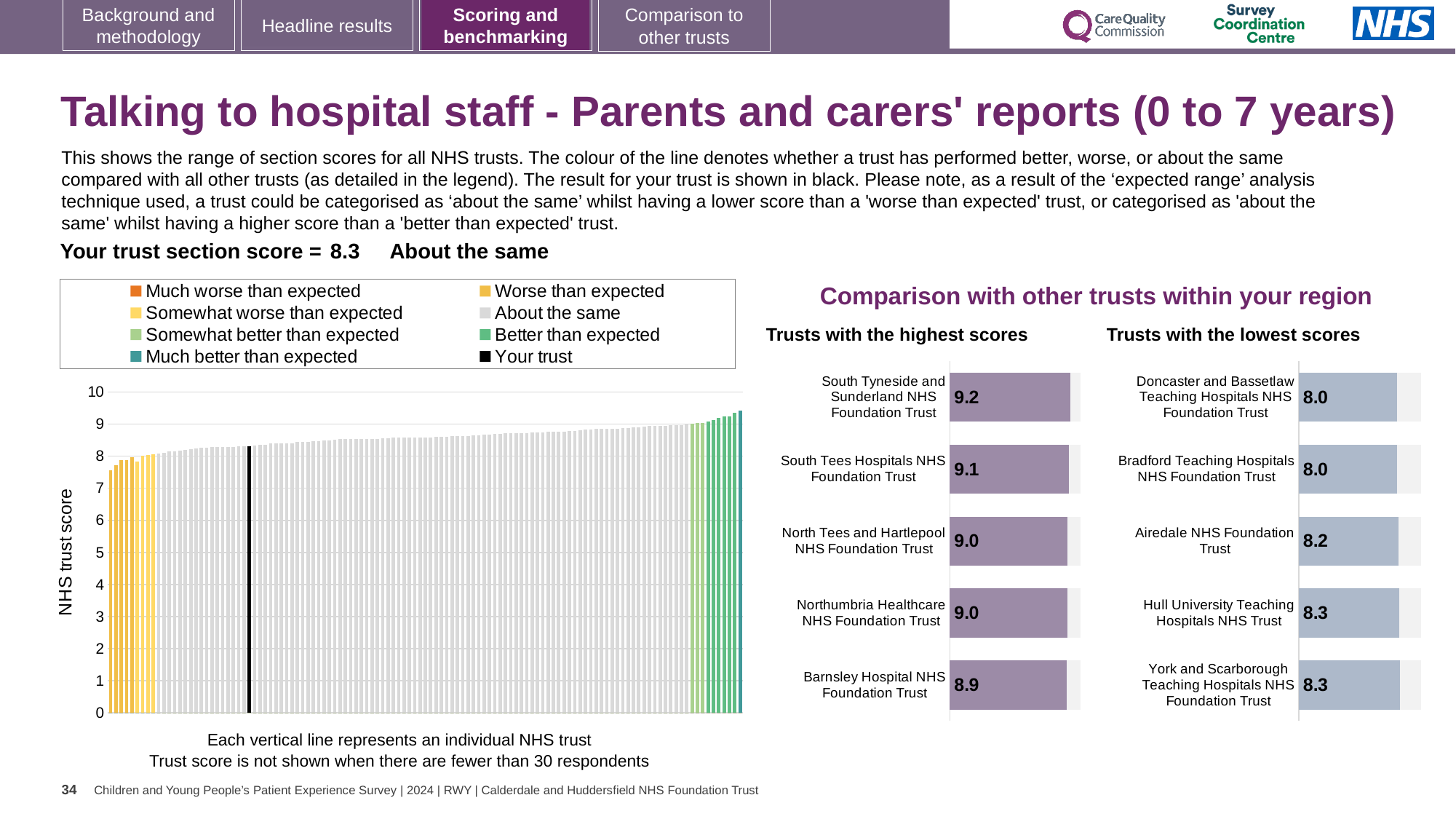
In the 'Trusts with the highest scores' chart, what is the difference between the scores of South Tyneside and Sunderland NHS Foundation Trust and Barnsley Hospital NHS Foundation Trust? 0.3 In the 'Trusts with the lowest scores' chart, what is the score for Airedale NHS Foundation Trust? 8.2 What kind of chart is the main chart showing the range of section scores for all NHS trusts? Bar chart In the main NHS trust score chart, what is the label on the vertical axis? NHS trust score Comparing the two regional charts, which has the larger score: South Tees Hospitals NHS Foundation Trust or Hull University Teaching Hospitals NHS Trust? South Tees Hospitals NHS Foundation Trust How many trusts are shown in the 'Trusts with the lowest scores' chart? 5 In the 'Trusts with the highest scores' chart, which trust has the lowest score? Barnsley Hospital NHS Foundation Trust How many entries does the legend of the main NHS trust score chart list? 8 In the 'Trusts with the highest scores' chart, what is the score for South Tyneside and Sunderland NHS Foundation Trust? 9.2 In the 'Trusts with the lowest scores' chart, what is the score for Bradford Teaching Hospitals NHS Foundation Trust? 8.0 In the 'Trusts with the highest scores' chart, which trust has the highest score? South Tyneside and Sunderland NHS Foundation Trust In the main NHS trust score chart, do the values rise or fall from left to right? Rise